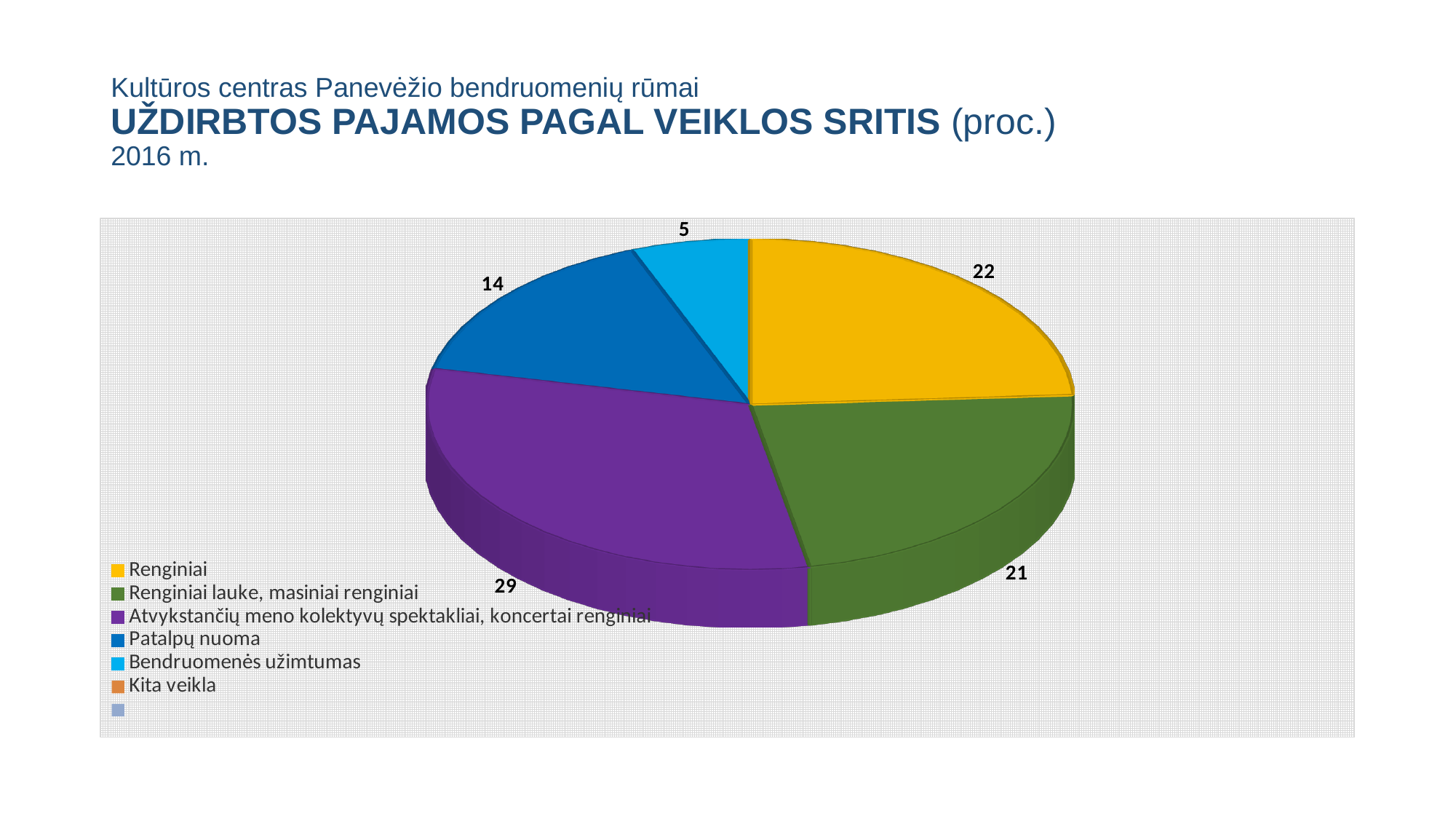
Which labelled slice has the smallest value in the pie chart? Bendruomenės užimtumas What is the difference between the values for Renginiai and Bendruomenės užimtumas? 17 What value is shown for the Atvykstančių meno kolektyvų spektakliai, koncertai renginiai slice? 29 What value is shown for the Patalpų nuoma slice? 14 What value is shown for the Renginiai lauke, masiniai renginiai slice? 21 What value is shown for the Renginiai slice? 22 Which category has the largest slice in the pie chart? Atvykstančių meno kolektyvų spektakliai, koncertai renginiai What value is shown for the Bendruomenės užimtumas slice? 5 What colour is the Patalpų nuoma slice in the pie chart? Dark blue Which is larger, the value for Renginiai or the value for Renginiai lauke, masiniai renginiai? Renginiai What is the difference between the values for Atvykstančių meno kolektyvų spektakliai, koncertai renginiai and Renginiai? 7 What kind of chart is shown on the slide? Pie chart